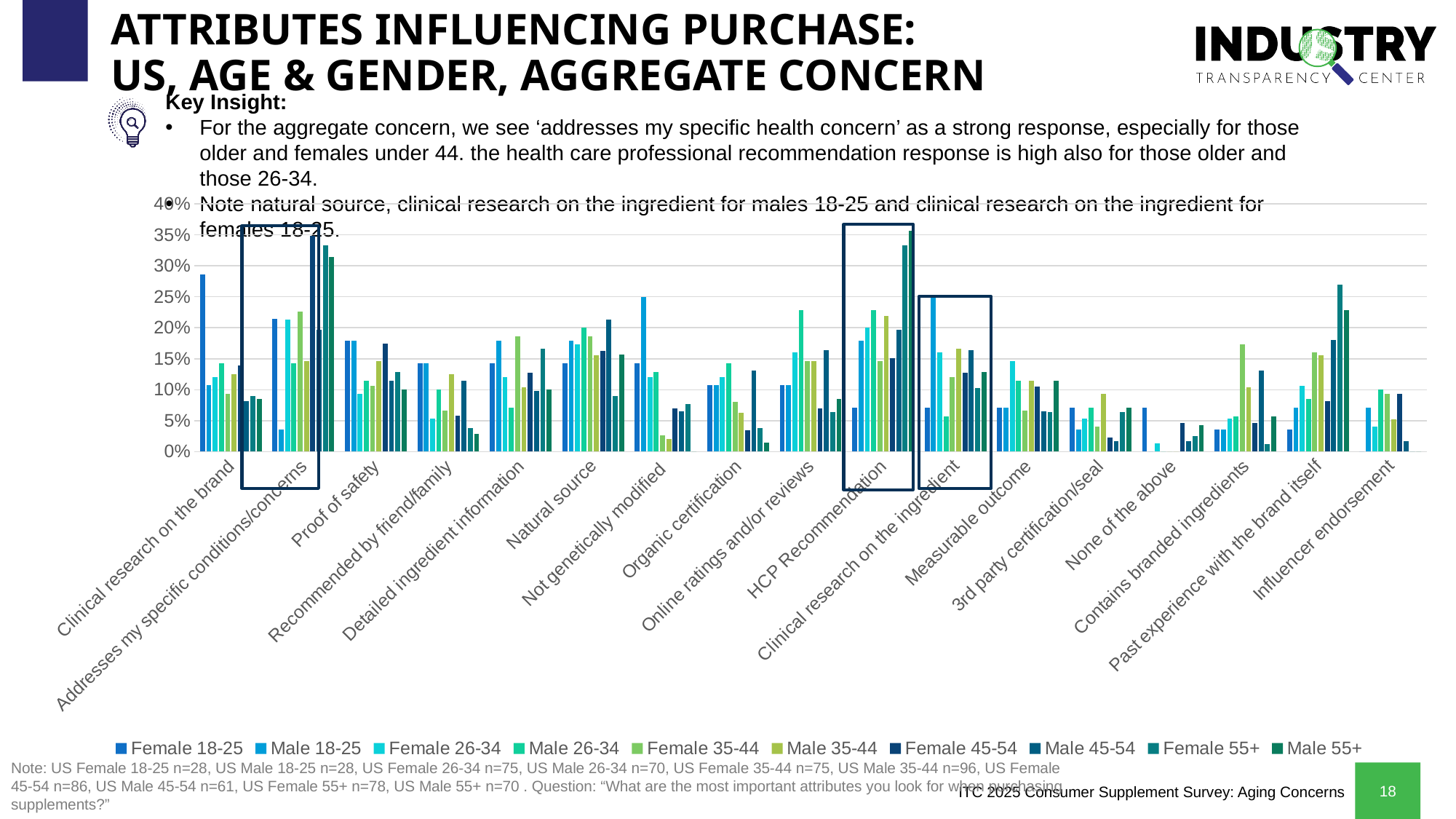
Is the value for Male 45-54 on 'Past experience with the brand itself' greater or less than 20%? less How many attribute categories are shown along the x axis? 17 Which series is listed first in the legend? Female 18-25 Is the value for Male 18-25 on 'Not genetically modified' greater or less than 20%? greater Is the value for Male 55+ on 'HCP Recommendation' greater or less than 30%? greater What kind of chart is shown on the slide? bar chart For Male 55+, which is larger: 'HCP Recommendation' or 'Influencer endorsement'? HCP Recommendation For Female 18-25, which is larger: 'Clinical research on the brand' or 'Proof of safety'? Clinical research on the brand How many series does the legend list? 10